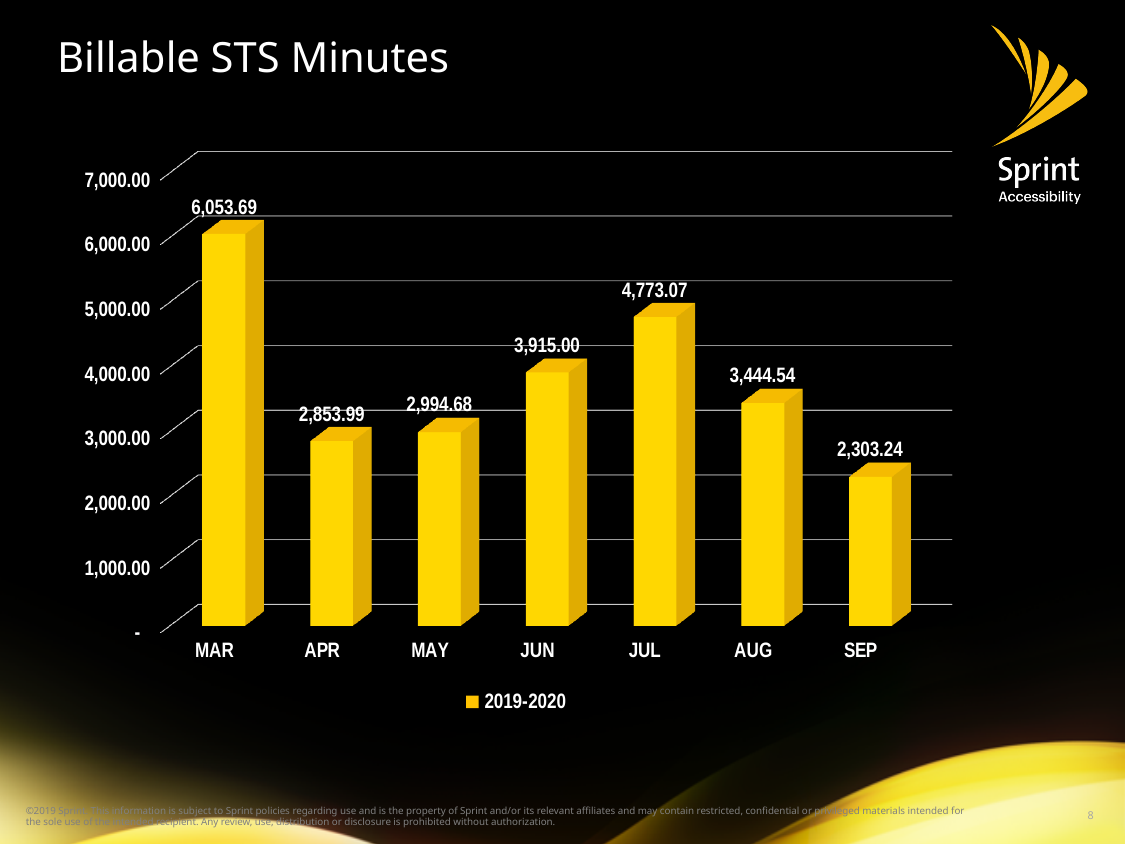
What is the value for MAR? 6,053.69 What is the difference between the values for JUL and JUN? 858.07 Which month has the highest value? MAR Which month has the lowest value? SEP Which is larger, the value for APR or the value for MAY? MAY What kind of chart is shown? bar chart How many months are shown on the x axis? 7 What is the difference between the values for MAR and SEP? 3,750.45 Is the value for JUL greater or less than 5,000.00? less What is the value for AUG? 3,444.54 Do the values rise or fall from JUL to SEP? fall What is the value for JUN? 3,915.00